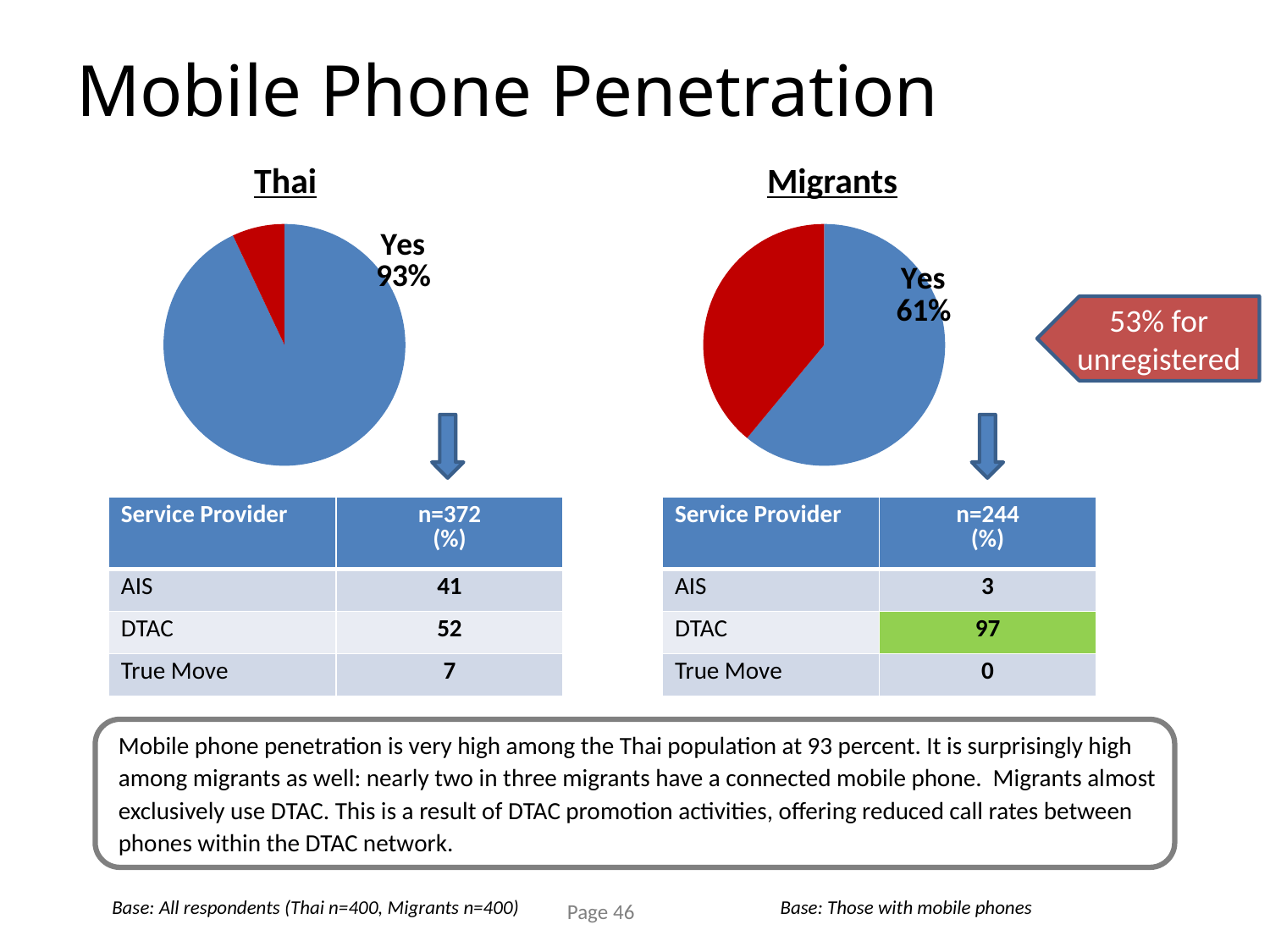
In the Migrants pie chart, which slice is the largest? Yes Which pie chart shows the larger Yes share, Thai or Migrants? Thai What is the title above the left pie chart? Thai What kind of chart is used for the Thai and Migrants mobile phone penetration data? Pie chart In the Thai pie chart, is the Yes share greater or less than 90%? greater In the Migrants pie chart, what share of respondents answered Yes? 61% What is the difference between the Yes share in the Thai pie chart and the Yes share in the Migrants pie chart? 32 percentage points In the Migrants pie chart, is the Yes share greater or less than 50%? greater What colour is the Yes slice in both pie charts? Blue How many slices does the Thai pie chart have? 2 In the Thai pie chart, what share of respondents answered Yes? 93% How many slices does the Migrants pie chart have? 2